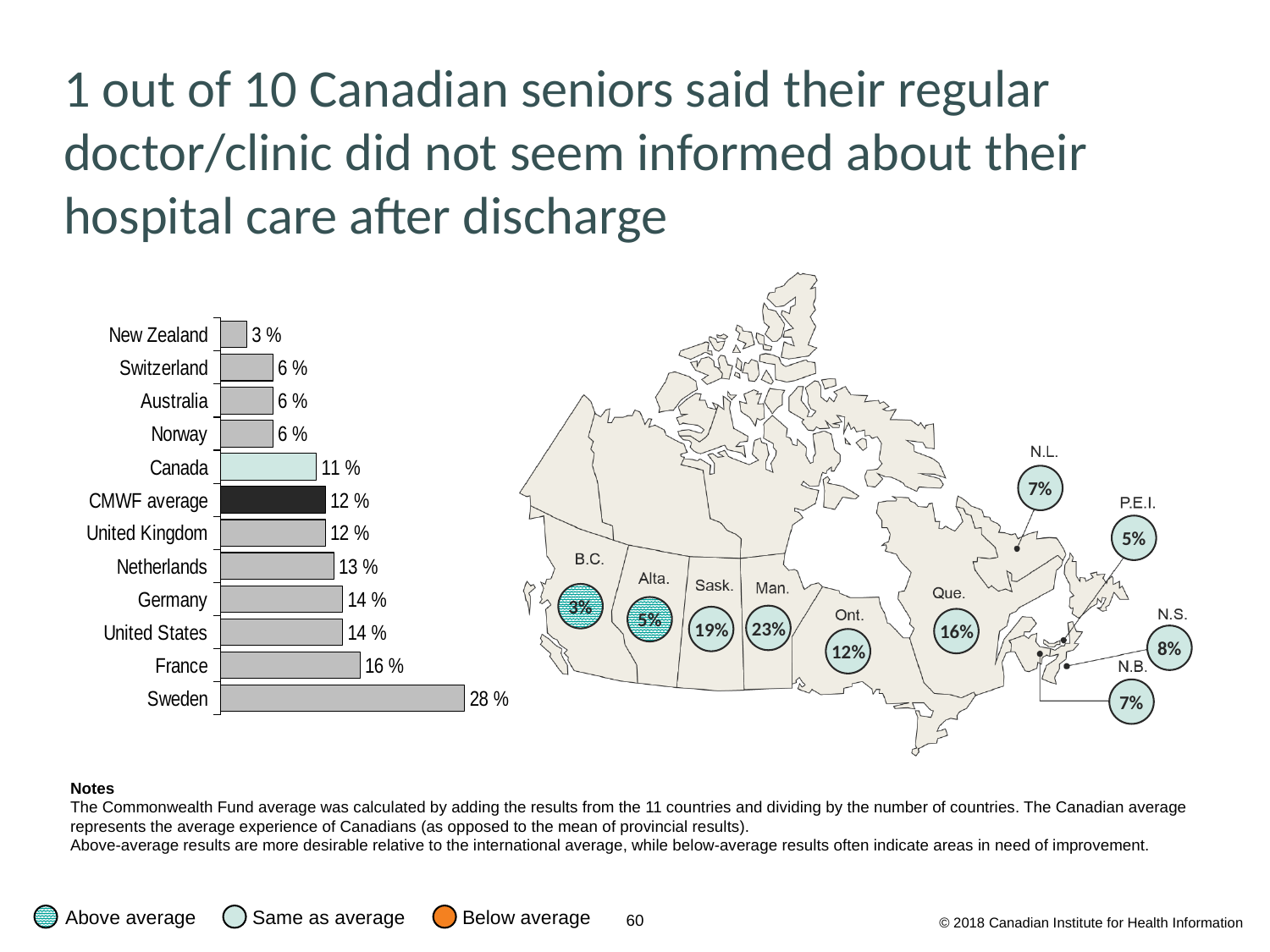
In the bar chart, what is the value for Canada? 11 % In the bar chart, what is the value for the CMWF average? 12 % How many categories (bars) are shown in the bar chart? 12 In the bar chart, what is the difference between the values for Sweden and Canada? 17 % On the map of Canada, which province has the lowest value? B.C. In the bar chart, what is the value for Sweden? 28 % In the bar chart, which country has the lowest value? New Zealand In the bar chart, which country has the highest value? Sweden On the map of Canada, what is the difference between the values for Sask. and Alta.? 14% What kind of chart is shown on the left of the slide? Bar chart In the bar chart, which has the larger value, France or Germany? France On the map of Canada, what is the value shown for Manitoba (Man.)? 23%